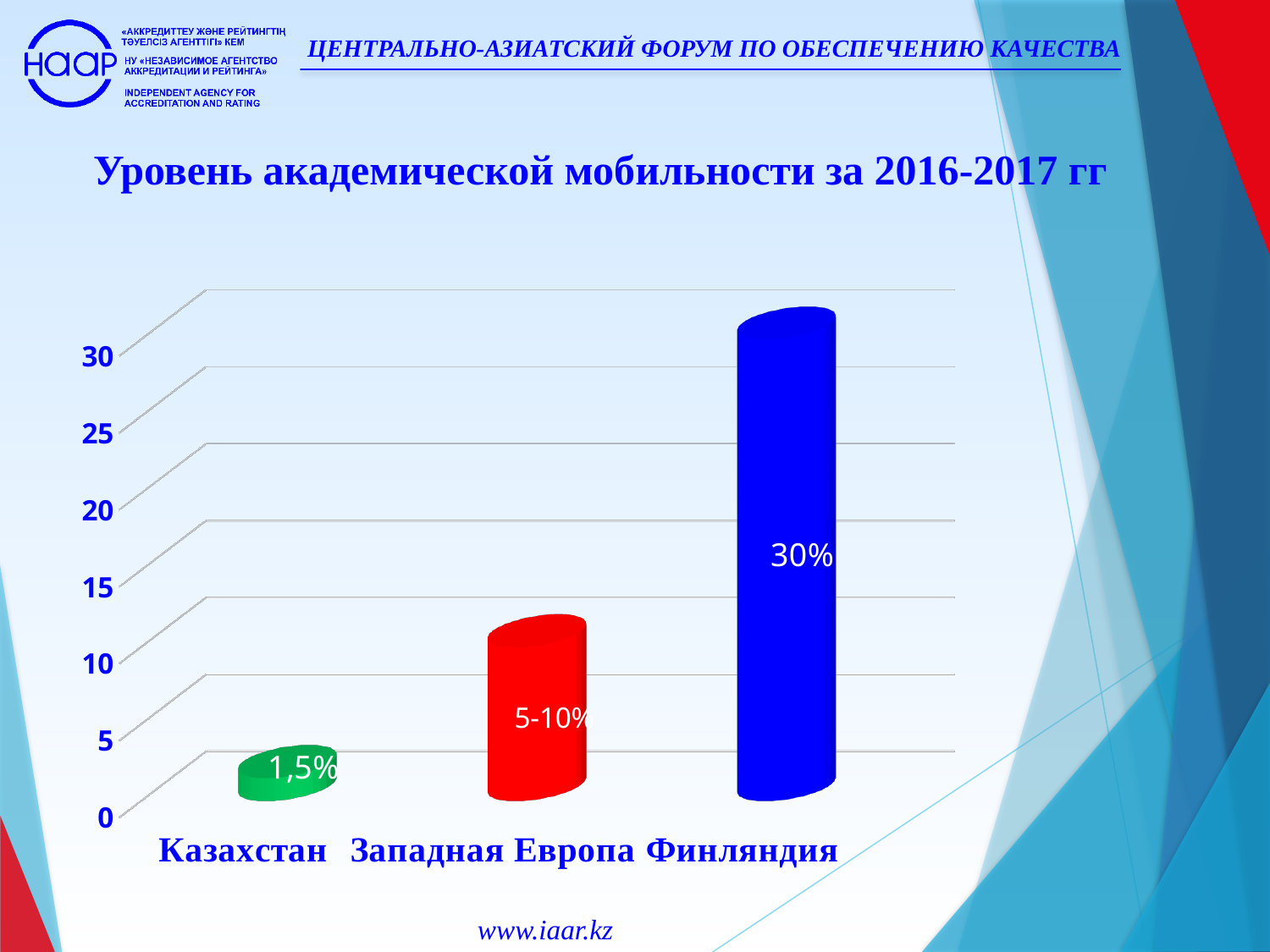
Is the value for Казахстан greater or less than 5? less Which category has the lowest value? Казахстан Which category has the highest value? Финляндия What kind of chart is shown on the slide? bar chart Is the value for Финляндия greater or less than 25? greater Do the values rise or fall from left to right along the x axis? rise How many categories are plotted in the chart? 3 What is the value shown for Финляндия? 30% What is the value shown for Казахстан? 1,5% Which is larger, the value for Финляндия or the value for Западная Европа? Финляндия What is the title of the chart? Уровень академической мобильности за 2016-2017 гг What is the value shown for Западная Европа? 5-10%